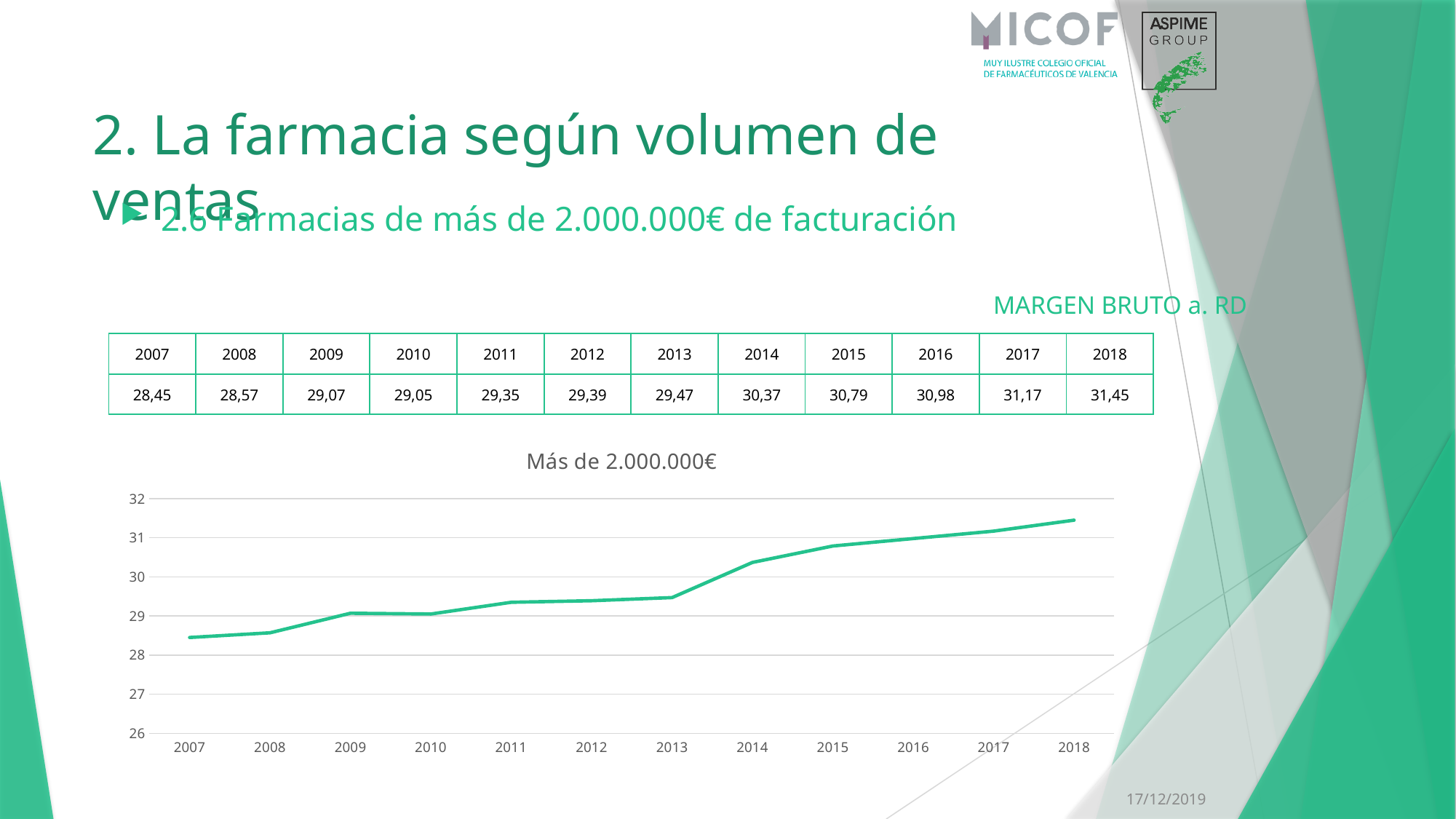
What is the difference between the values for 2018 and 2007? 3,00 Which year has the highest value? 2018 What is the value for 2014? 30,37 What type of chart is shown on the slide? Line chart How many years are plotted on the x axis of the chart? 12 Which year has the lowest value? 2007 Is the value for 2013 greater or less than 30? less Which is larger, the value for 2013 or the value for 2014? 2014 What is the value for 2018? 31,45 What is the value for 2007? 28,45 What is the title of the chart? Más de 2.000.000€ Do the values generally rise or fall from 2007 to 2018? rise